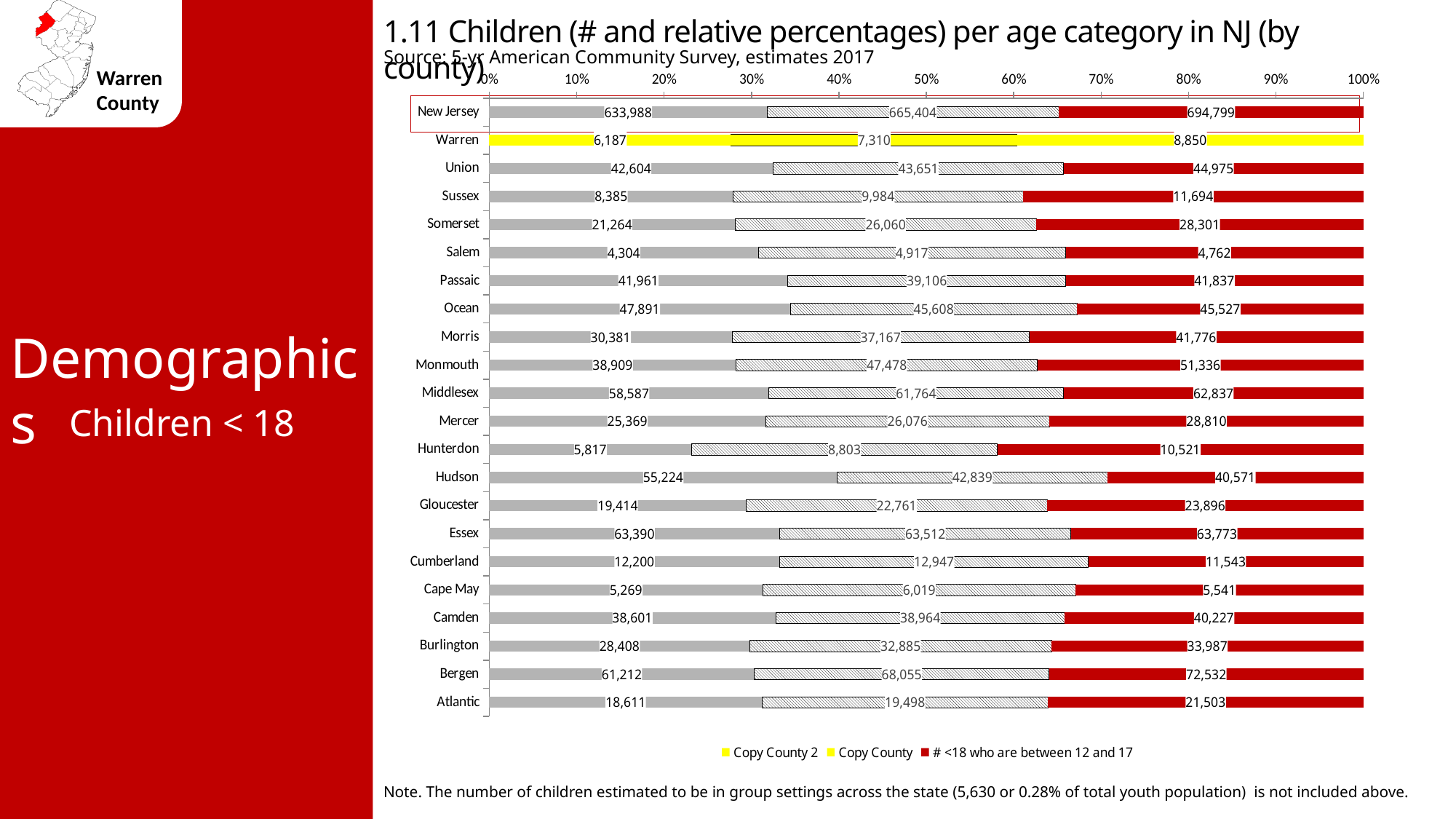
Is the share of the first (gray) segment for Hudson greater or less than 30%? greater For Warren, what is the difference between the red segment value (8,850) and the first gray segment value (6,187)? 2,663 What is the value of the red segment (# <18 who are between 12 and 17) for Atlantic? 21,503 What is the value of the red segment (# <18 who are between 12 and 17) for Warren? 8,850 Which is larger: the red segment value for Bergen or the red segment value for Essex? Bergen How many entries does the legend list? 3 Among the counties (excluding the New Jersey row), which has the largest value in the red segment (# <18 who are between 12 and 17)? Bergen What is the value of the middle (hatched) segment for Hudson? 42,839 Among the counties (excluding the New Jersey row), which has the smallest value in the red segment (# <18 who are between 12 and 17)? Salem How many rows (categories) are plotted on the chart? 22 What is the total of the three segment values shown for Warren? 22,347 What is the value of the first (gray) segment for New Jersey? 633,988